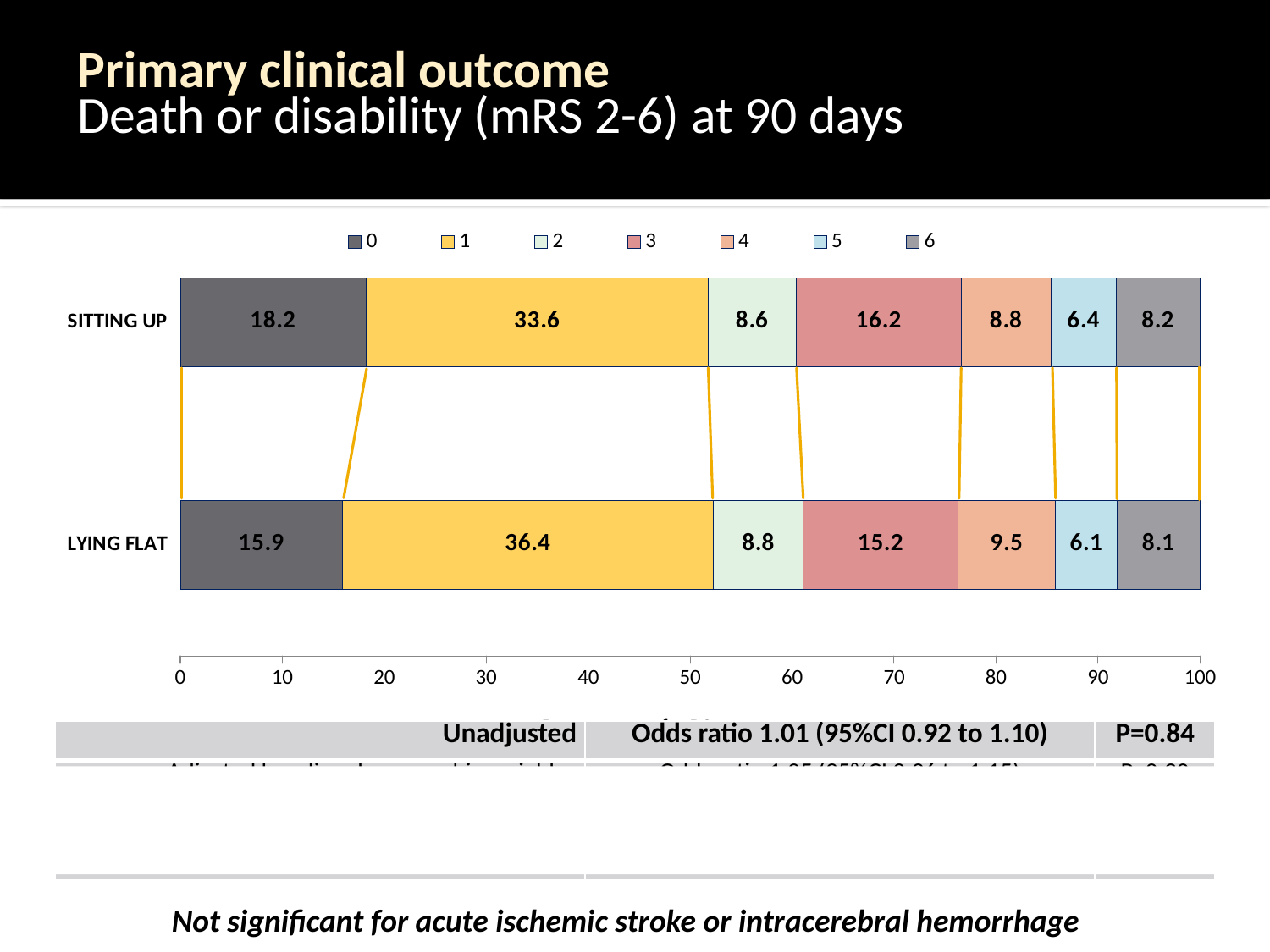
How many series does the legend list? 7 What is the difference between the mRS 1 values for LYING FLAT and SITTING UP? 2.8 What kind of chart is shown on the slide? Stacked bar chart What is the value for mRS 0 in the LYING FLAT bar? 15.9 What is the total of the SITTING UP stacked bar? 100 What is the value for mRS 5 in the SITTING UP bar? 6.4 Which bar has the larger value for mRS 0, SITTING UP or LYING FLAT? SITTING UP What is the value for mRS 1 in the SITTING UP bar? 33.6 Which mRS category has the smallest value in the LYING FLAT bar? 5 What is the value for mRS 3 in the LYING FLAT bar? 15.2 How many categories (bars) are plotted in the chart? 2 Which mRS category has the largest value in the SITTING UP bar? 1